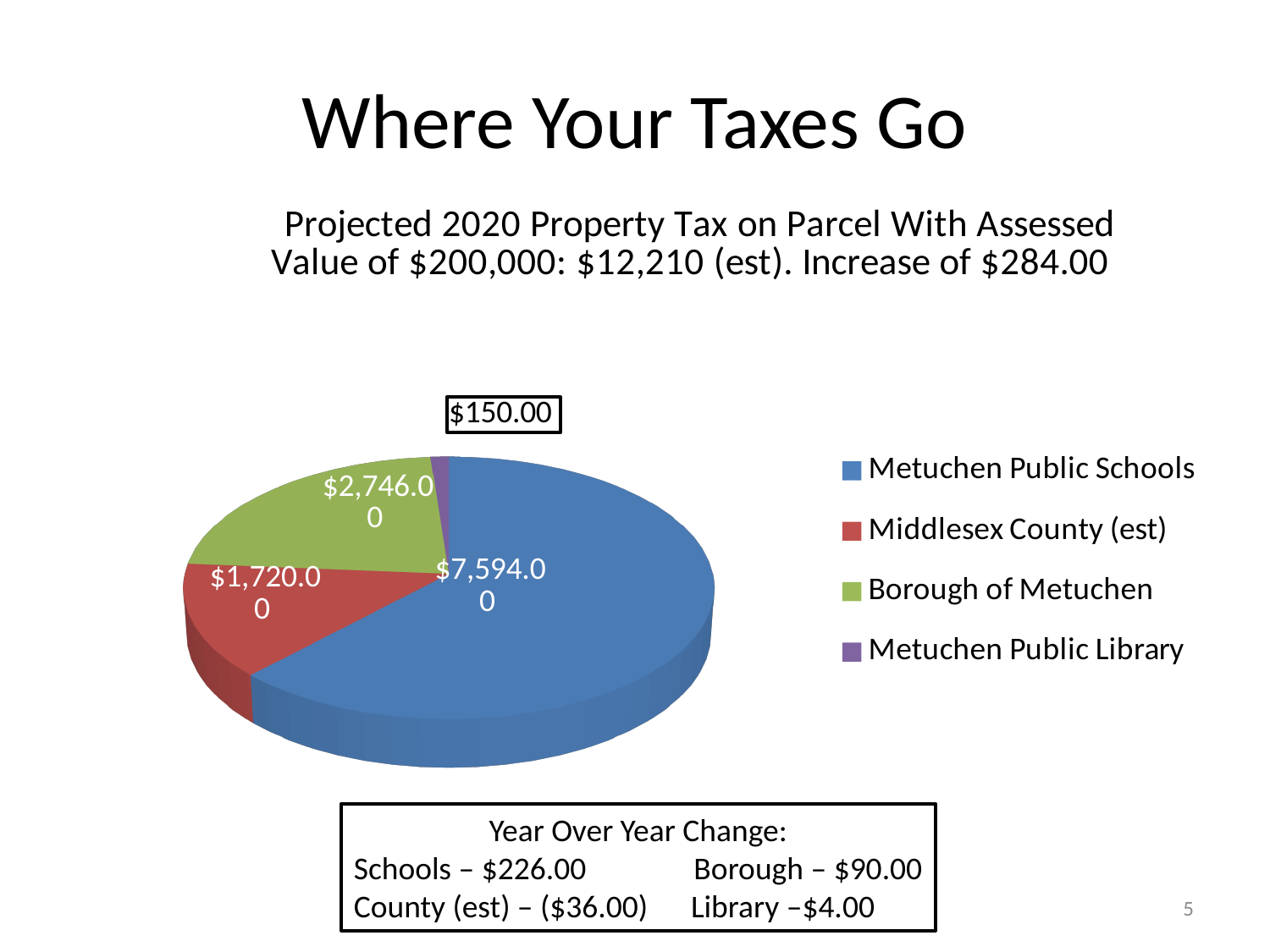
How many categories does the pie chart legend list? 4 Which is larger, the Borough of Metuchen slice or the Middlesex County (est) slice? Borough of Metuchen What is the value for Metuchen Public Library in the pie chart? $150.00 Which category has the largest slice of the pie chart? Metuchen Public Schools What is the total of all four slices in the pie chart? $12,210.00 What is the value for Borough of Metuchen in the pie chart? $2,746.00 What kind of chart is shown on the slide? Pie chart What is the value for Metuchen Public Schools in the pie chart? $7,594.00 Which category has the smallest slice of the pie chart? Metuchen Public Library What is the value for Middlesex County (est) in the pie chart? $1,720.00 How much larger is the Metuchen Public Schools value than the Borough of Metuchen value? $4,848.00 What is the difference between the Borough of Metuchen and Middlesex County (est) values? $1,026.00